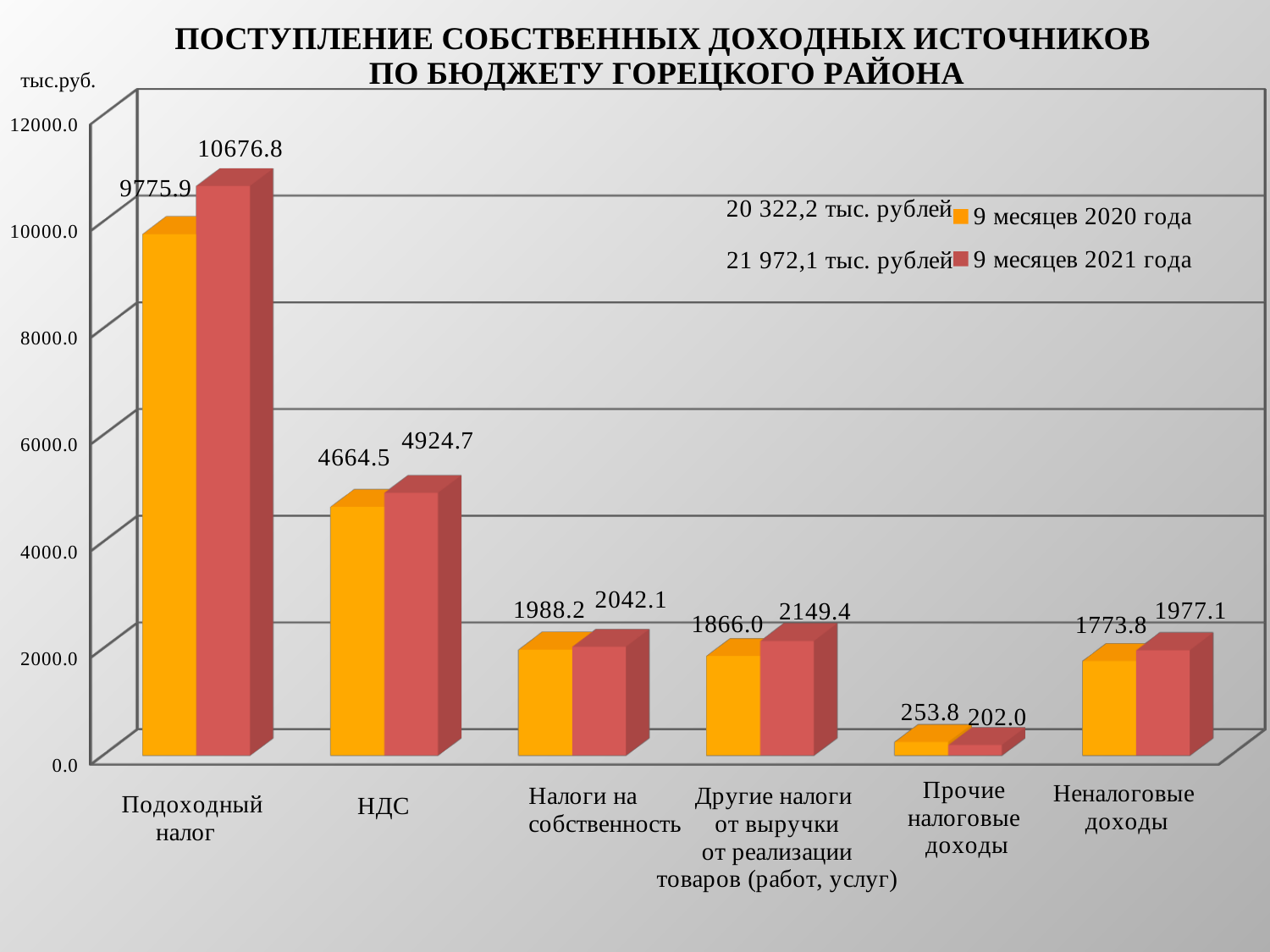
What is the value for НДС in the 9 месяцев 2021 года series? 4924.7 Which category has the highest value in the 9 месяцев 2021 года series? Подоходный налог What is the value for Подоходный налог in the 9 месяцев 2020 года series? 9775.9 What is the value for Прочие налоговые доходы in the 9 месяцев 2021 года series? 202.0 What kind of chart is shown on the slide? Bar chart For Прочие налоговые доходы, which series has the larger value: 9 месяцев 2020 года or 9 месяцев 2021 года? 9 месяцев 2020 года What is the difference between the 9 месяцев 2021 года and 9 месяцев 2020 года values for НДС? 260.2 How many categories are shown on the x axis? 6 How many series does the legend list? 2 What is the value for Неналоговые доходы in the 9 месяцев 2020 года series? 1773.8 What is the difference between the 9 месяцев 2021 года and 9 месяцев 2020 года values for Подоходный налог? 900.9 Which category has the lowest value in the 9 месяцев 2020 года series? Прочие налоговые доходы